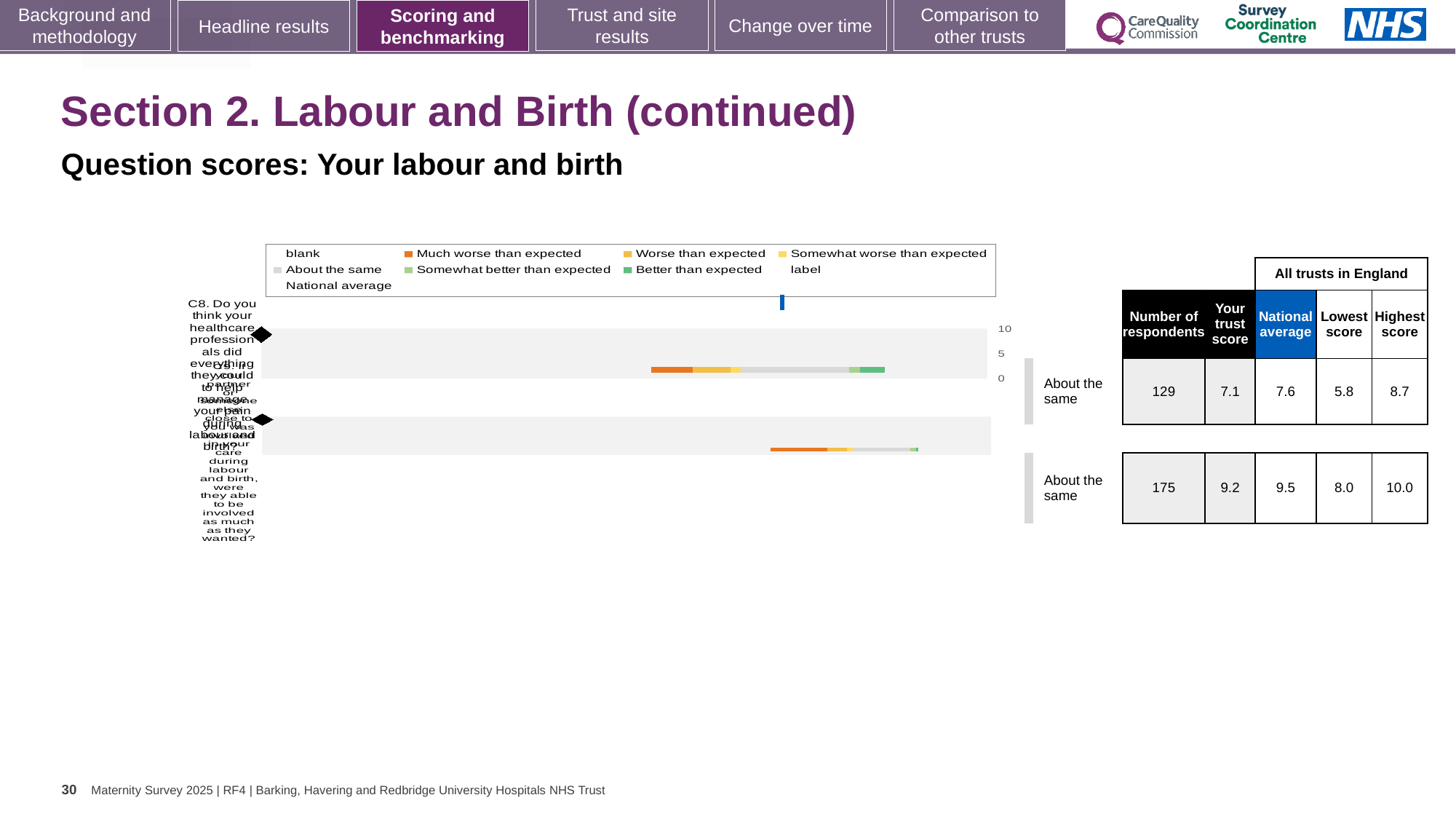
What is the difference between the national average and the trust score for the first question row? 0.5 What colour represents 'Much worse than expected' in the chart legend? orange What kind of chart is shown on the slide? bar chart In the table, what is the national average for the first question row? 7.6 What is the highest value shown on the chart's numeric axis? 10 In the table, what is the number of respondents for the first question row? 129 In the table, what is the trust score for the second question row? 9.2 Which question row has the higher trust score, the first or the second? the second How many question rows are plotted in the chart? 2 In the table, what is the number of respondents for the second question row? 175 In the table, what is the highest score across all trusts in England for the second question row? 10.0 In the table, what is the trust score for the first question row? 7.1